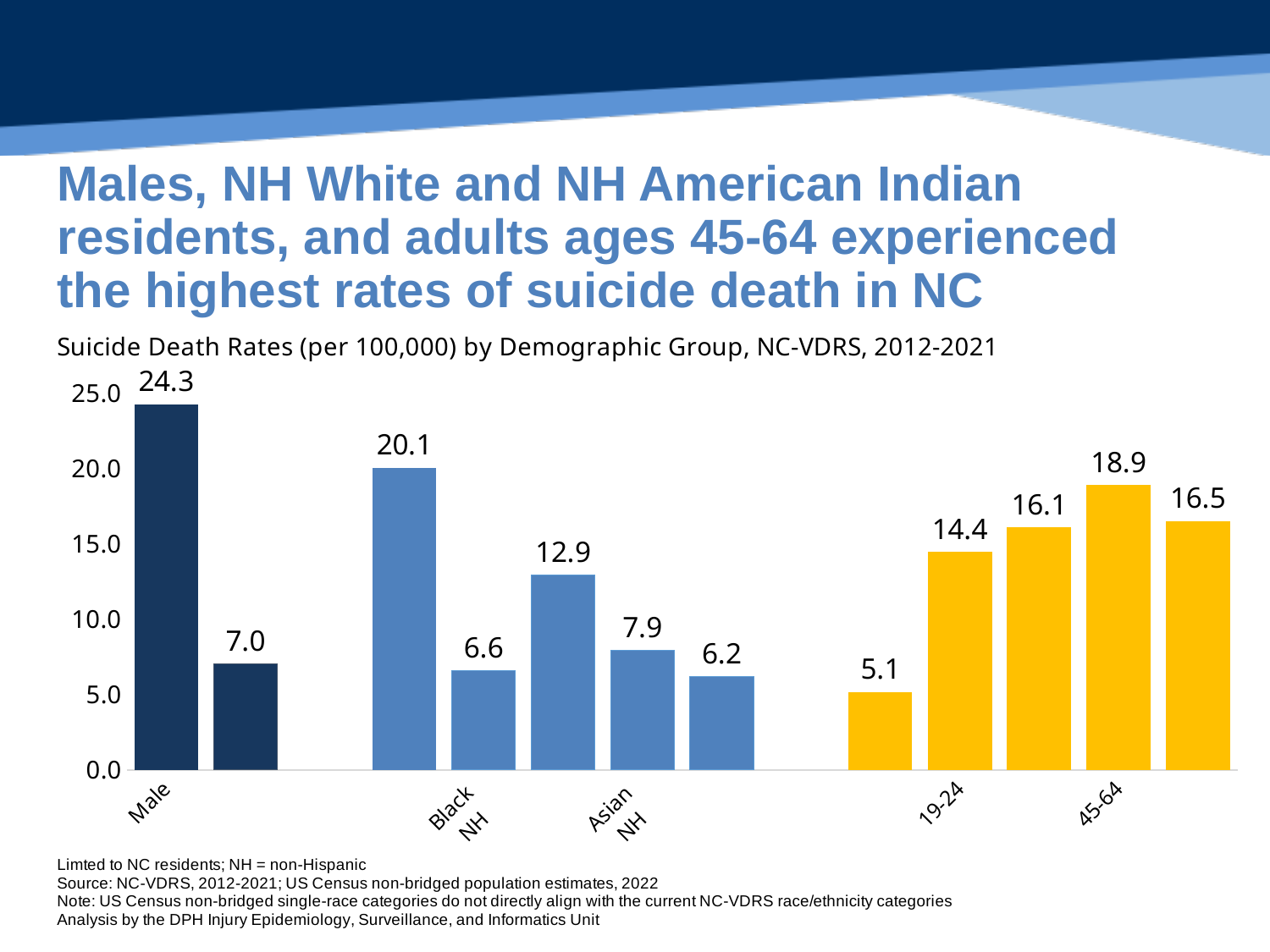
Which has a higher suicide death rate, Asian NH or Black NH residents? Asian NH What is the suicide death rate for Black NH residents? 6.6 What is the suicide death rate for Asian NH residents? 7.9 What is the suicide death rate for adults ages 45-64? 18.9 What is the suicide death rate for adults ages 19-24? 14.4 What kind of chart is shown on the slide? Bar chart How many bars are plotted on the chart? 12 Which labeled category has the highest suicide death rate on the chart? Male What is the difference between the suicide death rate for ages 45-64 and ages 19-24? 4.5 What is the difference between the suicide death rate for Male residents and for Black NH residents? 17.7 What is the lowest value shown on the chart? 5.1 What is the suicide death rate for Male residents? 24.3